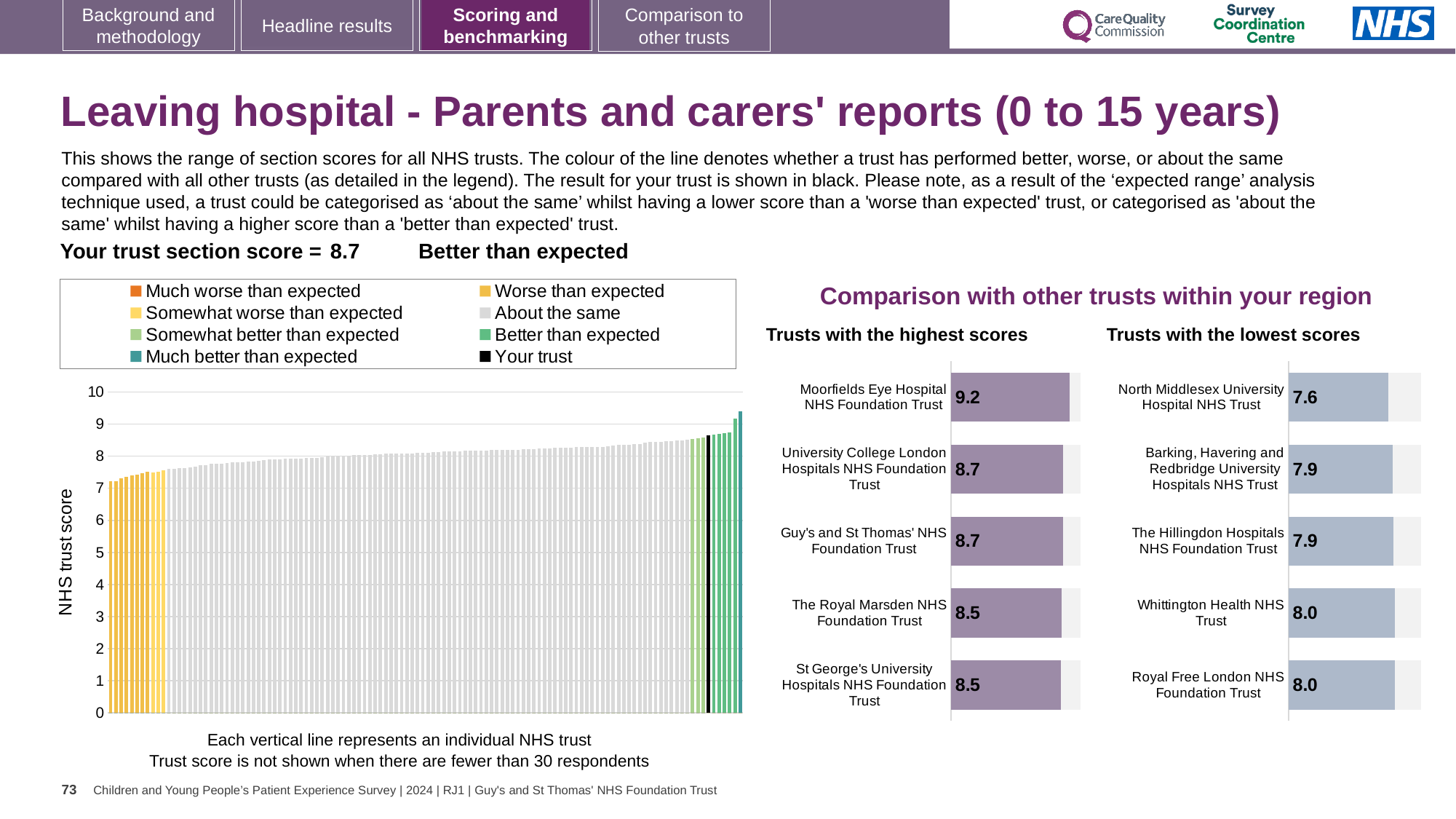
In the 'Trusts with the lowest scores' chart, which has the higher score: Royal Free London NHS Foundation Trust or The Hillingdon Hospitals NHS Foundation Trust? Royal Free London NHS Foundation Trust In the main NHS trust score chart on the left, is the value of the leftmost (lowest) bar greater or less than 8? less In the 'Trusts with the highest scores' chart, which trust has the highest score? Moorfields Eye Hospital NHS Foundation Trust In the 'Trusts with the lowest scores' chart, which trust has the lowest score? North Middlesex University Hospital NHS Trust In the 'Trusts with the highest scores' chart, what is the difference between the scores of Moorfields Eye Hospital NHS Foundation Trust and The Royal Marsden NHS Foundation Trust? 0.7 How many trusts are listed in the 'Trusts with the highest scores' chart? 5 In the 'Trusts with the highest scores' chart, what is the score for Moorfields Eye Hospital NHS Foundation Trust? 9.2 In the main NHS trust score chart on the left, do the trust scores rise or fall from left to right? rise How many entries does the legend of the main NHS trust score chart list? 8 In the 'Trusts with the lowest scores' chart, what is the score for North Middlesex University Hospital NHS Trust? 7.6 In the main NHS trust score chart on the left, what is the section score for your trust (the black bar)? 8.7 In the 'Trusts with the lowest scores' chart, what is the difference between the scores of Whittington Health NHS Trust and North Middlesex University Hospital NHS Trust? 0.4